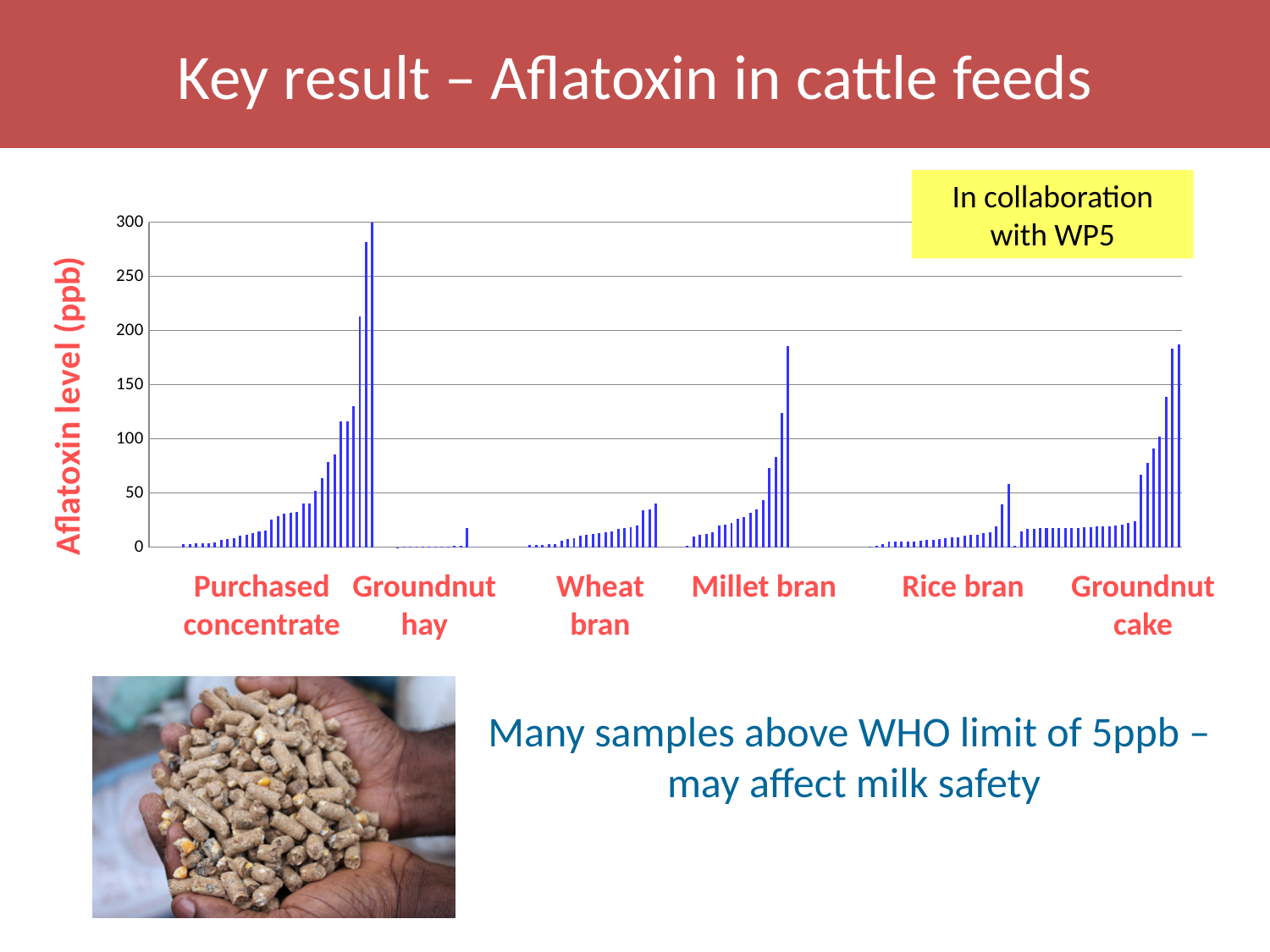
What kind of chart is shown on the slide? bar chart How many feed types are labelled along the bottom of the chart? 6 What is the highest value shown on the vertical axis of the chart? 300 Which group has the taller maximum bar, Millet bran or Wheat bran? Millet bran Is the tallest bar in the Wheat bran group greater or less than 50? less Which feed type contains the tallest bar in the chart? Purchased concentrate What is the label on the vertical axis of the chart? Aflatoxin level (ppb) Is the tallest bar in the Millet bran group greater or less than 150? greater Is the tallest bar in the Rice bran group greater or less than 100? less Which feed type has the lowest aflatoxin levels overall, with bars barely visible above zero? Groundnut hay Which group has the taller maximum bar, Purchased concentrate or Groundnut cake? Purchased concentrate